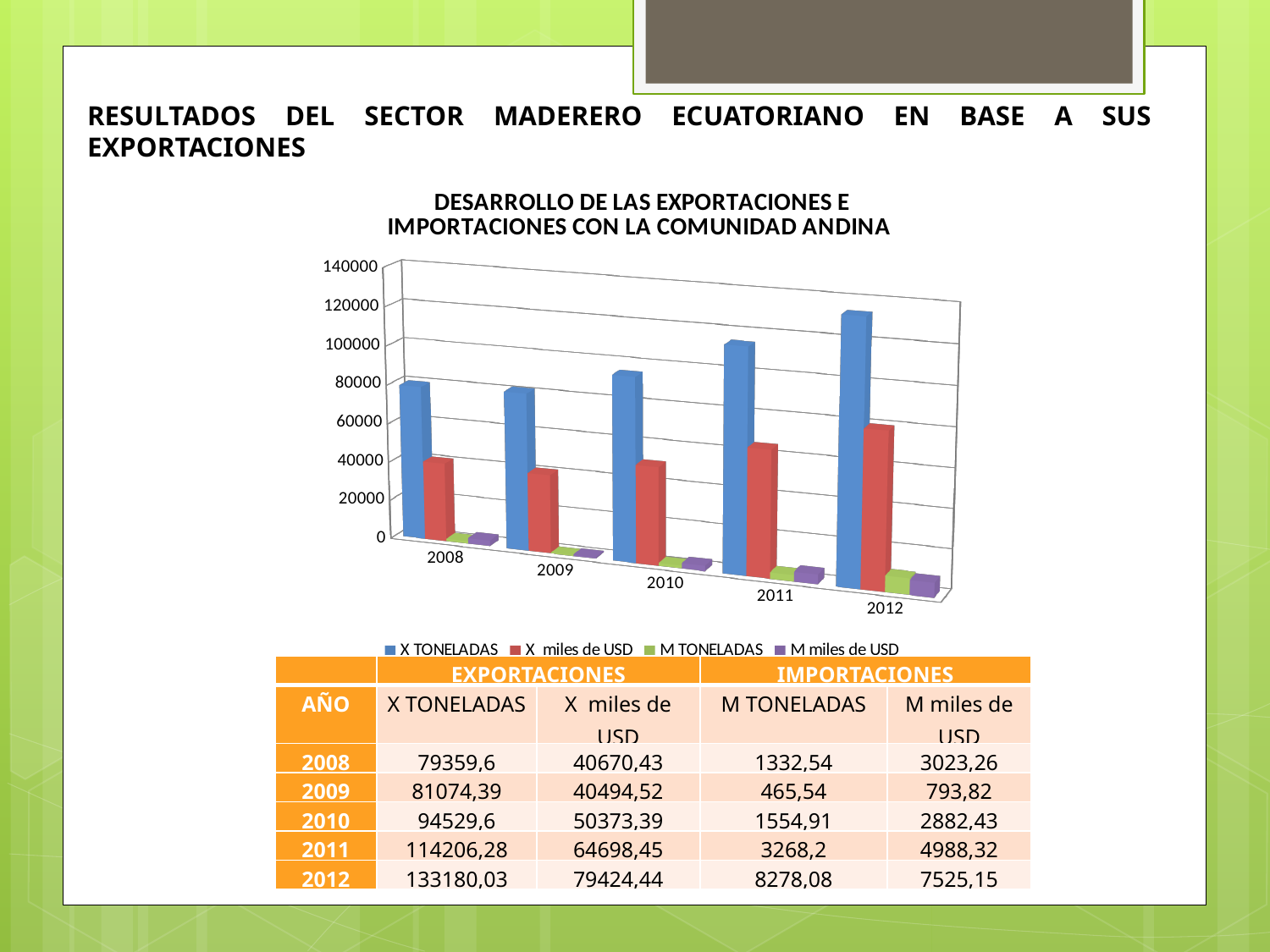
How many years are shown on the x axis of the chart? 5 What is the difference between the X TONELADAS values for 2012 and 2011? 18973,75 What is the value of X TONELADAS for 2012? 133180,03 What kind of chart is shown on the slide? bar chart What colour represents the X TONELADAS series in the chart? blue How many series does the chart legend list? 4 What is the value of M miles de USD for 2009? 793,82 Which year has the larger value for X miles de USD, 2010 or 2011? 2011 Which year has the lowest value for M TONELADAS? 2009 Does the X TONELADAS series rise or fall from 2008 to 2012? rises What is the title of the chart? DESARROLLO DE LAS EXPORTACIONES E IMPORTACIONES CON LA COMUNIDAD ANDINA Which year has the highest value for X TONELADAS? 2012